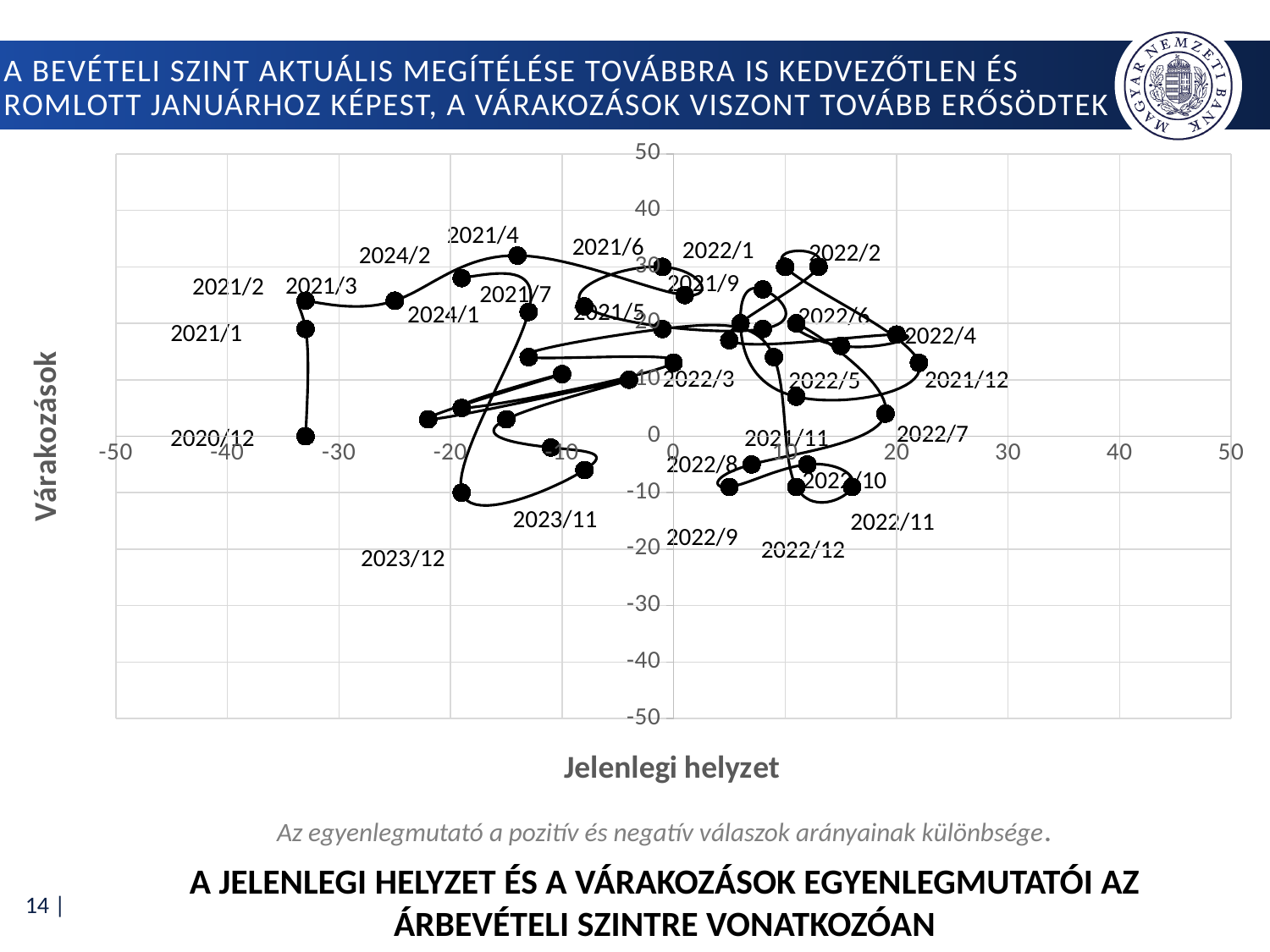
What is the title of the vertical axis of the chart? Várakozások Is the Várakozások value for the point labelled 2021/4 greater or less than 20? greater Is the Várakozások value for the point labelled 2021/2 greater or less than 20? greater Is the Jelenlegi helyzet value for the point labelled 2023/12 greater or less than -10? less Which point has the higher Várakozások value, 2021/4 or 2022/9? 2021/4 What is the title of the horizontal axis of the chart? Jelenlegi helyzet What kind of chart is shown on the slide? scatter chart